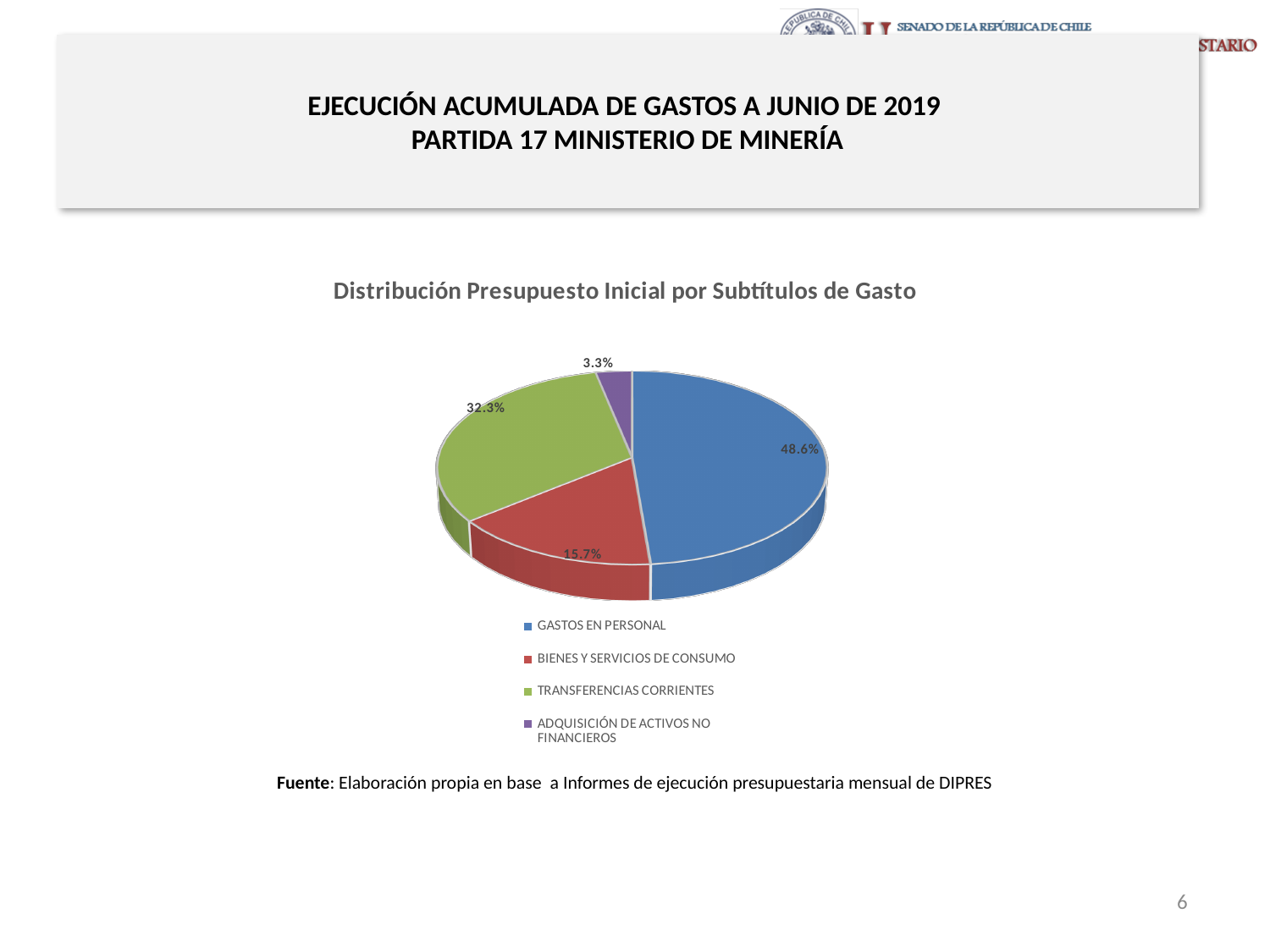
How many categories does the pie chart show? 4 Which category has the largest slice of the pie? GASTOS EN PERSONAL What share of the pie does TRANSFERENCIAS CORRIENTES represent? 32.3% Which is larger, the share for BIENES Y SERVICIOS DE CONSUMO or the share for TRANSFERENCIAS CORRIENTES? TRANSFERENCIAS CORRIENTES What is the difference in percentage points between GASTOS EN PERSONAL and TRANSFERENCIAS CORRIENTES? 16.3 percentage points Which category has the smallest slice of the pie? ADQUISICIÓN DE ACTIVOS NO FINANCIEROS What share of the pie does BIENES Y SERVICIOS DE CONSUMO represent? 15.7% What colour is the slice for TRANSFERENCIAS CORRIENTES? Green What share of the pie does ADQUISICIÓN DE ACTIVOS NO FINANCIEROS represent? 3.3% What kind of chart is shown on the slide? Pie chart What is the title of the chart? Distribución Presupuesto Inicial por Subtítulos de Gasto